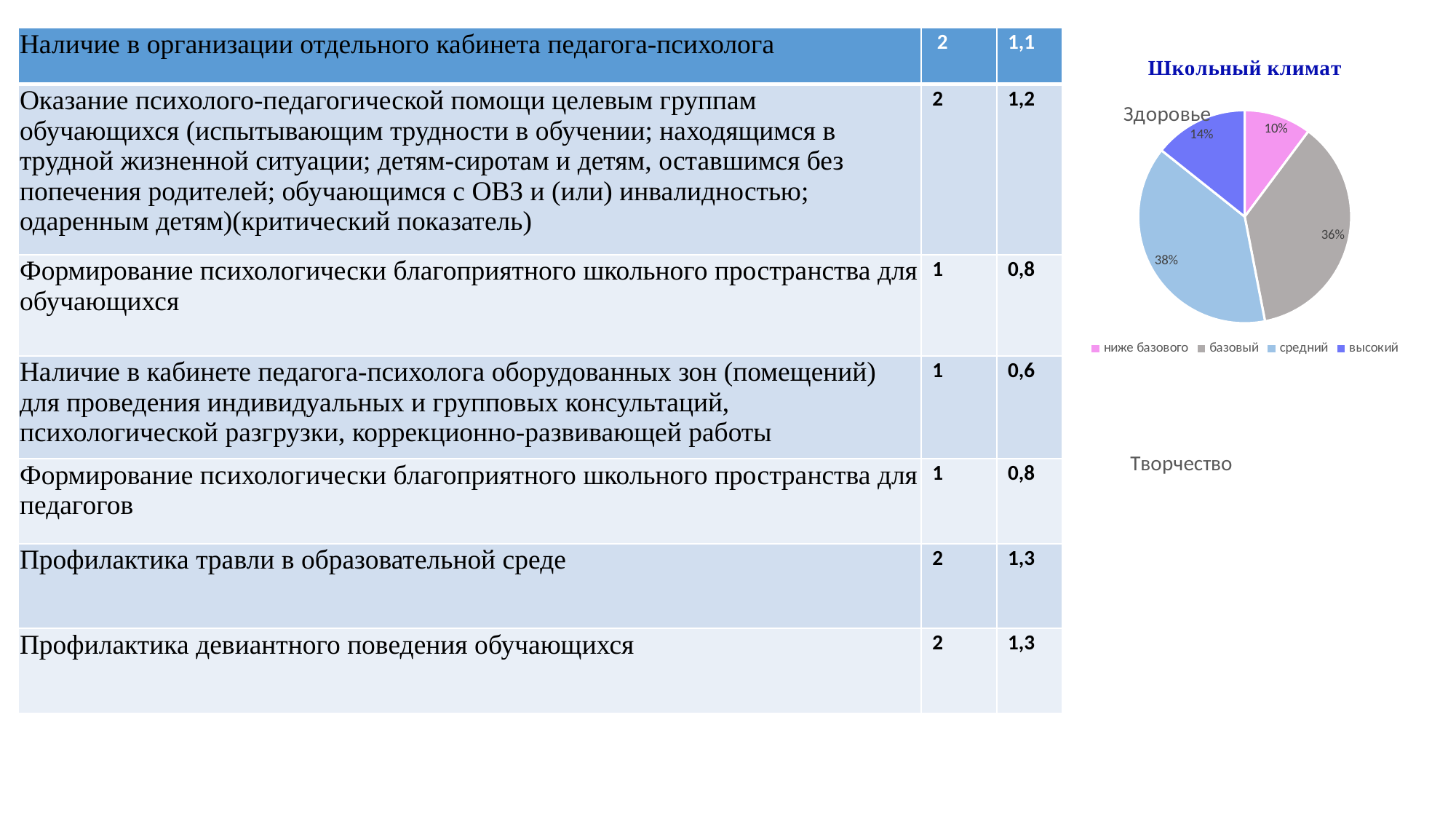
How many slices does the "Школьный климат" pie chart have? 4 In the "Школьный климат" pie chart, how many percentage points larger is "базовый" than "ниже базового"? 26% In the "Школьный климат" pie chart, what share is labelled for "средний"? 38% What kind of chart is shown under the title "Школьный климат"? pie chart In the "Школьный климат" pie chart, which category is shown in pink? ниже базового Which category has the smallest slice in the "Школьный климат" pie chart? ниже базового In the "Школьный климат" pie chart, what share is labelled for "базовый"? 36% In the "Школьный климат" pie chart, what share is labelled for "ниже базового"? 10% Which category has the largest slice in the "Школьный климат" pie chart? средний In the "Школьный климат" pie chart, how many percentage points larger is "средний" than "высокий"? 24% In the "Школьный климат" pie chart, what share is labelled for "высокий"? 14% In the "Школьный климат" pie chart, which slice is larger: "высокий" or "ниже базового"? высокий